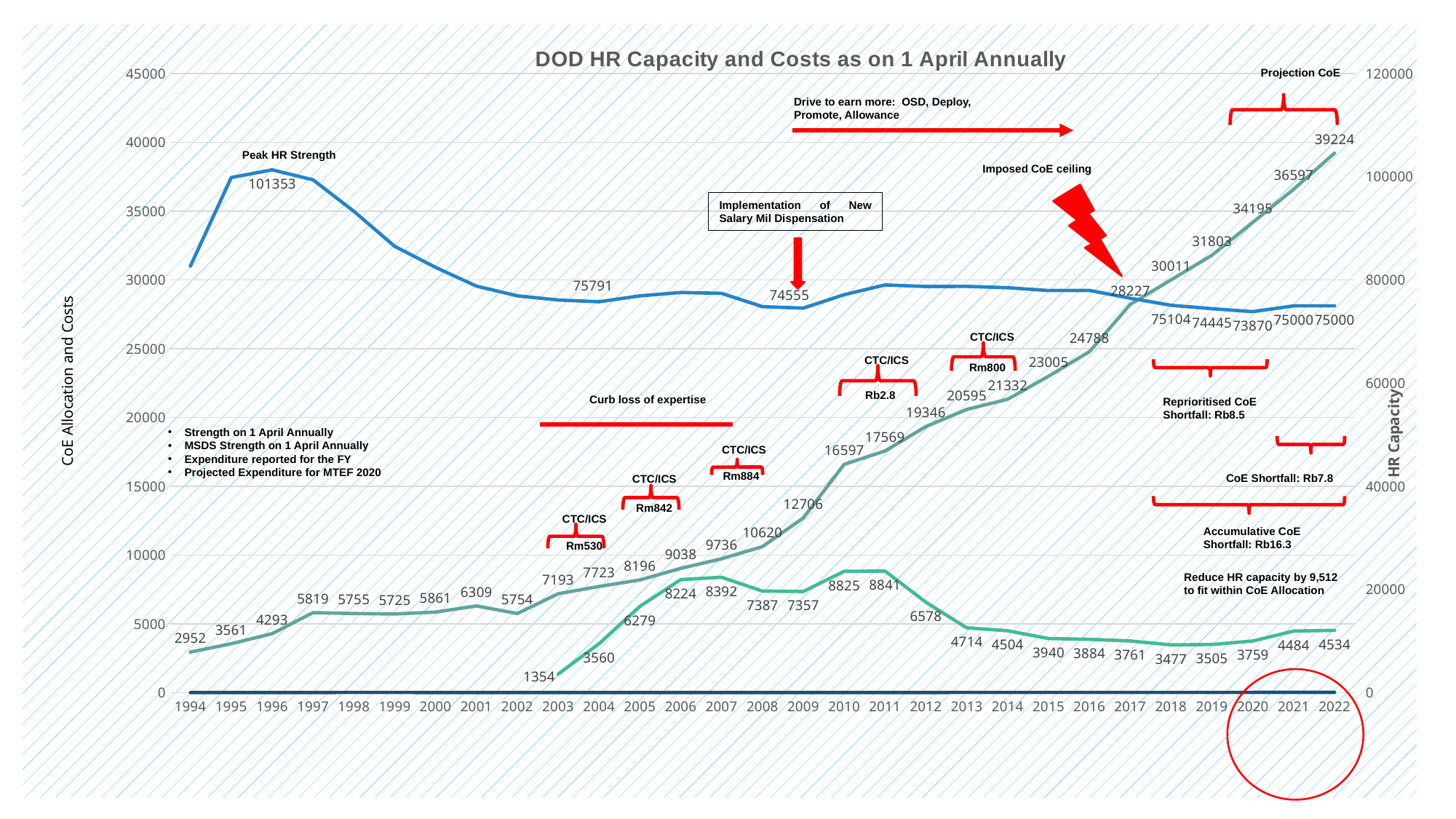
What is the HR strength value labelled for 2020? 73870 What is the MSDS strength value labelled for 2003? 1354 Does the expenditure line rise or fall from 1994 to 2022? rise What is the expenditure value labelled for 2022? 39224 How many years are shown on the x axis of the chart? 29 What is the highest labelled value on the MSDS strength line? 8841 What is the difference between the expenditure values for 2022 and 2021? 2627 What kind of chart is shown on the slide? line chart In which year does the MSDS strength line reach its lowest labelled value? 2003 What is the title of the chart? DOD HR Capacity and Costs as on 1 April Annually What is the peak HR strength value labelled on the chart? 101353 Which year has the larger MSDS strength value, 2006 or 2007? 2007